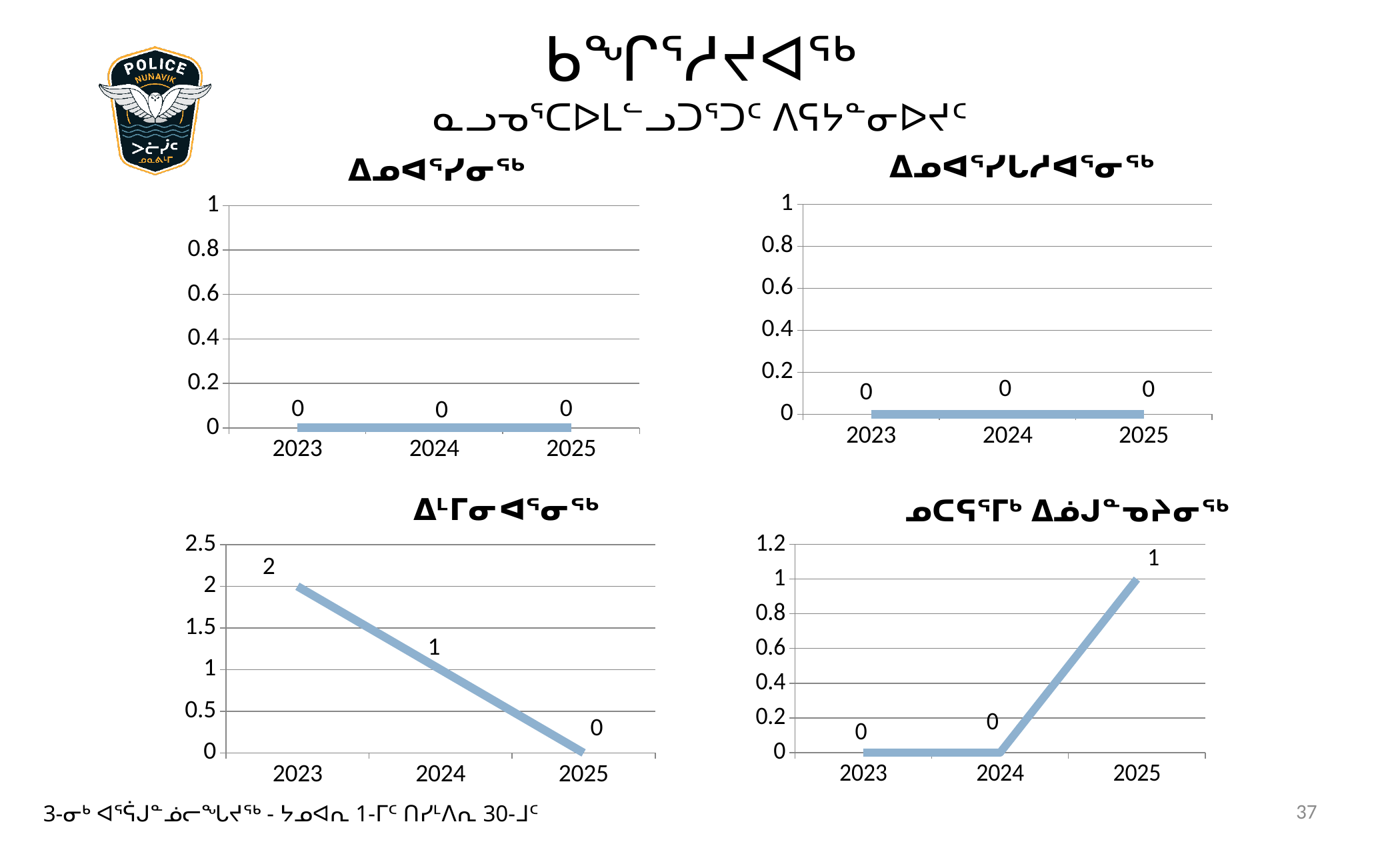
In the bottom-left chart, what is the difference between the values for 2023 and 2025? 2 In the bottom-left chart, what is the value for 2023? 2 What kind of chart is the bottom-right chart? line chart In the bottom-left chart, what is the value for 2024? 1 In the bottom-right chart, what is the value for 2025? 1 In the bottom-left chart, which year has the lowest value? 2025 In the top-left chart, what is the value for 2024? 0 How many years are plotted on the x axis of the top-right chart? 3 In the bottom-right chart, which year has the highest value? 2025 In the bottom-left chart, which year has the highest value? 2023 In the bottom-right chart, is the value for 2024 larger or smaller than the value for 2025? smaller In the bottom-left chart, do the values rise or fall from 2023 to 2025? fall